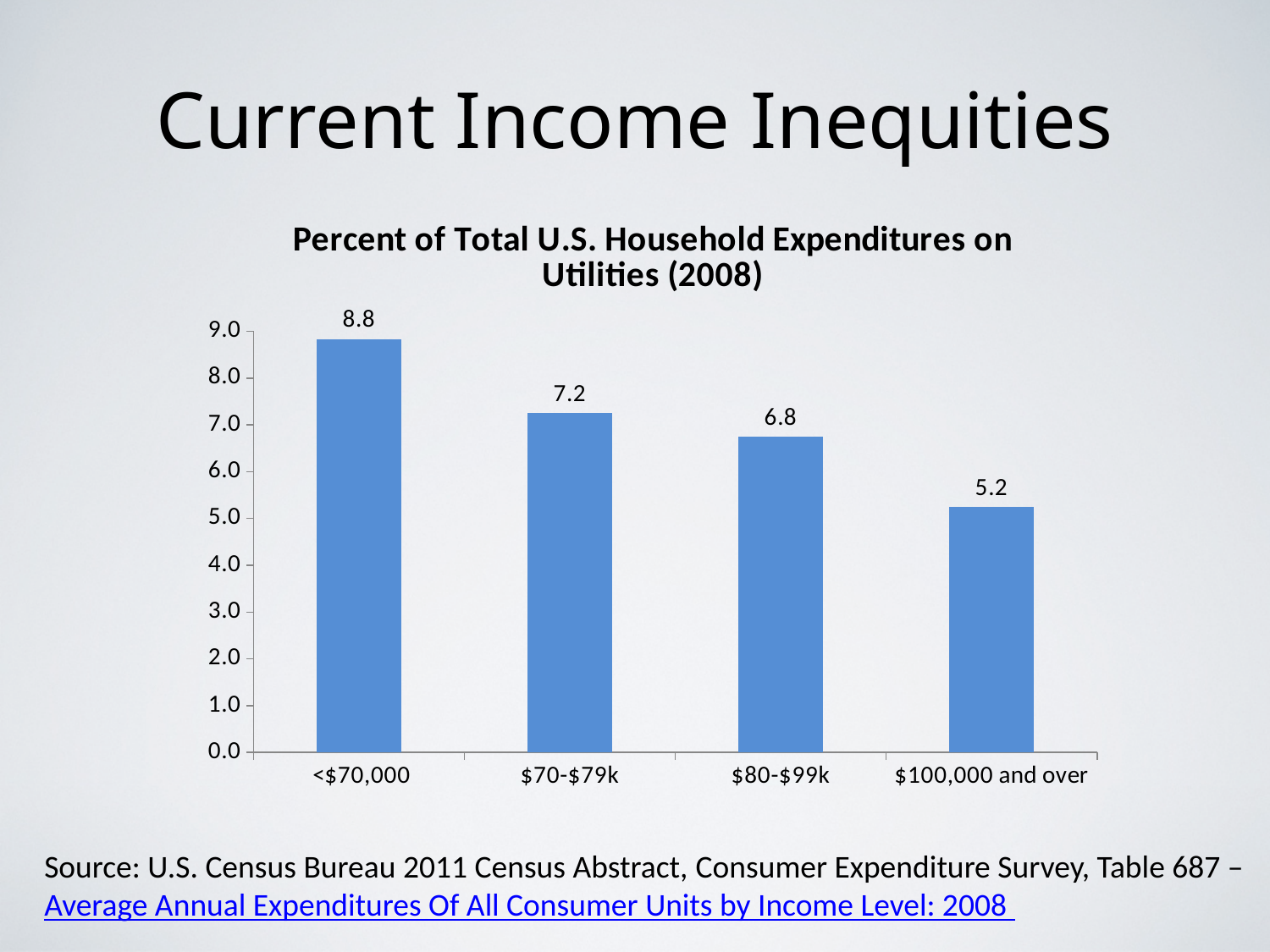
How many income groups are shown in the chart? 4 What kind of chart is shown on the slide? bar chart What is the difference between the values for <$70,000 and $100,000 and over? 3.6 What is the value for the $100,000 and over income group? 5.2 Do the values rise or fall as income level increases along the x axis? fall Which is larger, the value for $70-$79k or the value for $80-$99k? $70-$79k Which income group has the highest percent of household expenditures on utilities? <$70,000 What is the value for the <$70,000 income group? 8.8 What is the value for the $80-$99k income group? 6.8 Is the value for $80-$99k greater or less than 6.0? greater What is the value for the $70-$79k income group? 7.2 Which income group has the lowest percent of household expenditures on utilities? $100,000 and over